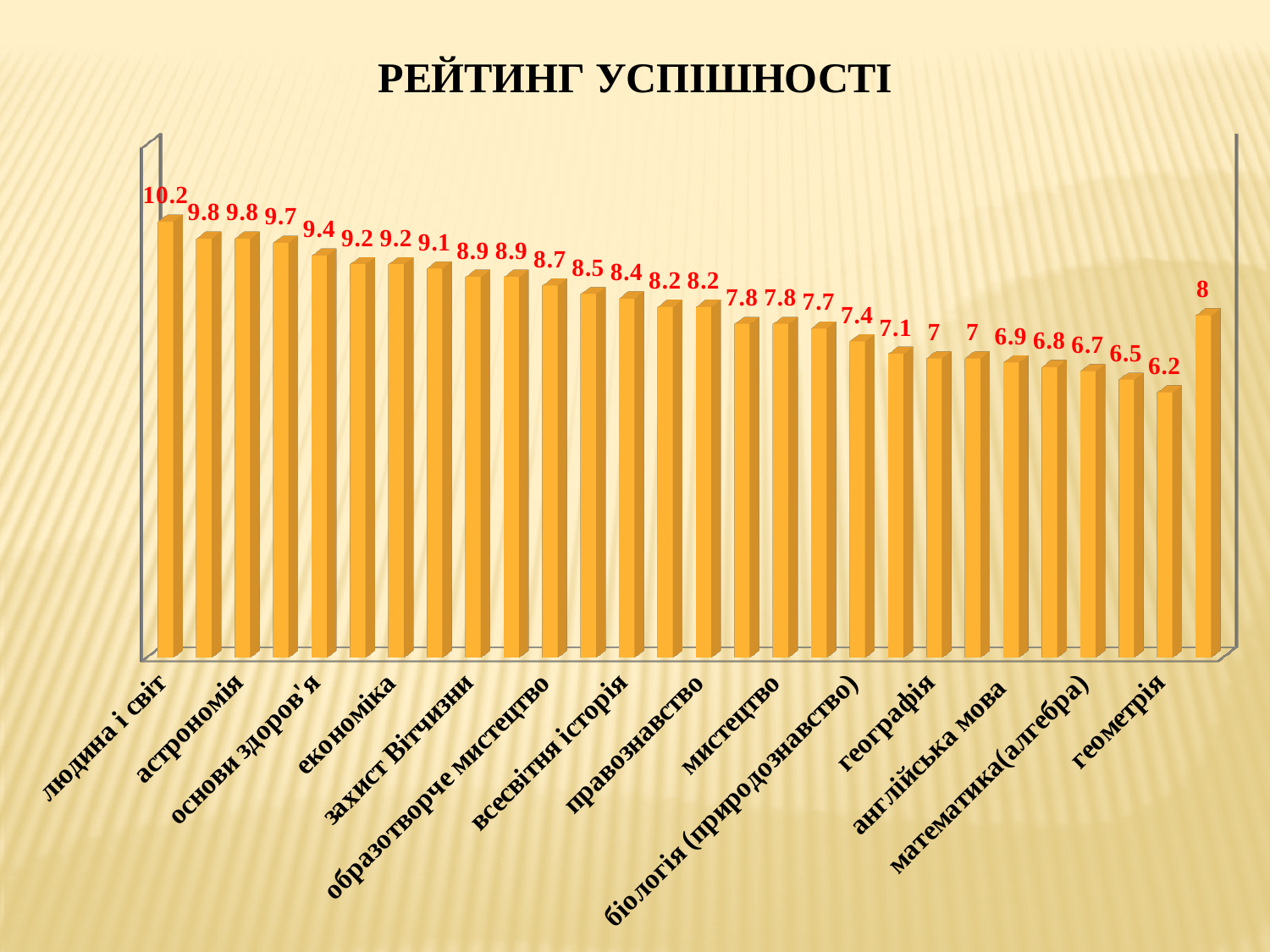
Which category has the highest value in the chart? людина і світ What is the title of the chart? РЕЙТИНГ УСПІШНОСТІ What is the difference between the highest value (10.2) and the lowest value (6.2)? 4 What kind of chart is shown on the slide? bar chart Which is larger: the first bar (людина і світ) or the last bar? the first bar (людина і світ) What is the value of the last (rightmost) bar in the chart? 8 What is the highest value shown in the chart? 10.2 Do the values generally rise or fall from left to right across the chart (excluding the final bar)? fall What is the value of the first bar, labelled 'людина і світ'? 10.2 What is the lowest value shown in the chart? 6.2 How many bars are plotted in the chart? 28 What colour are the bars in the chart? orange